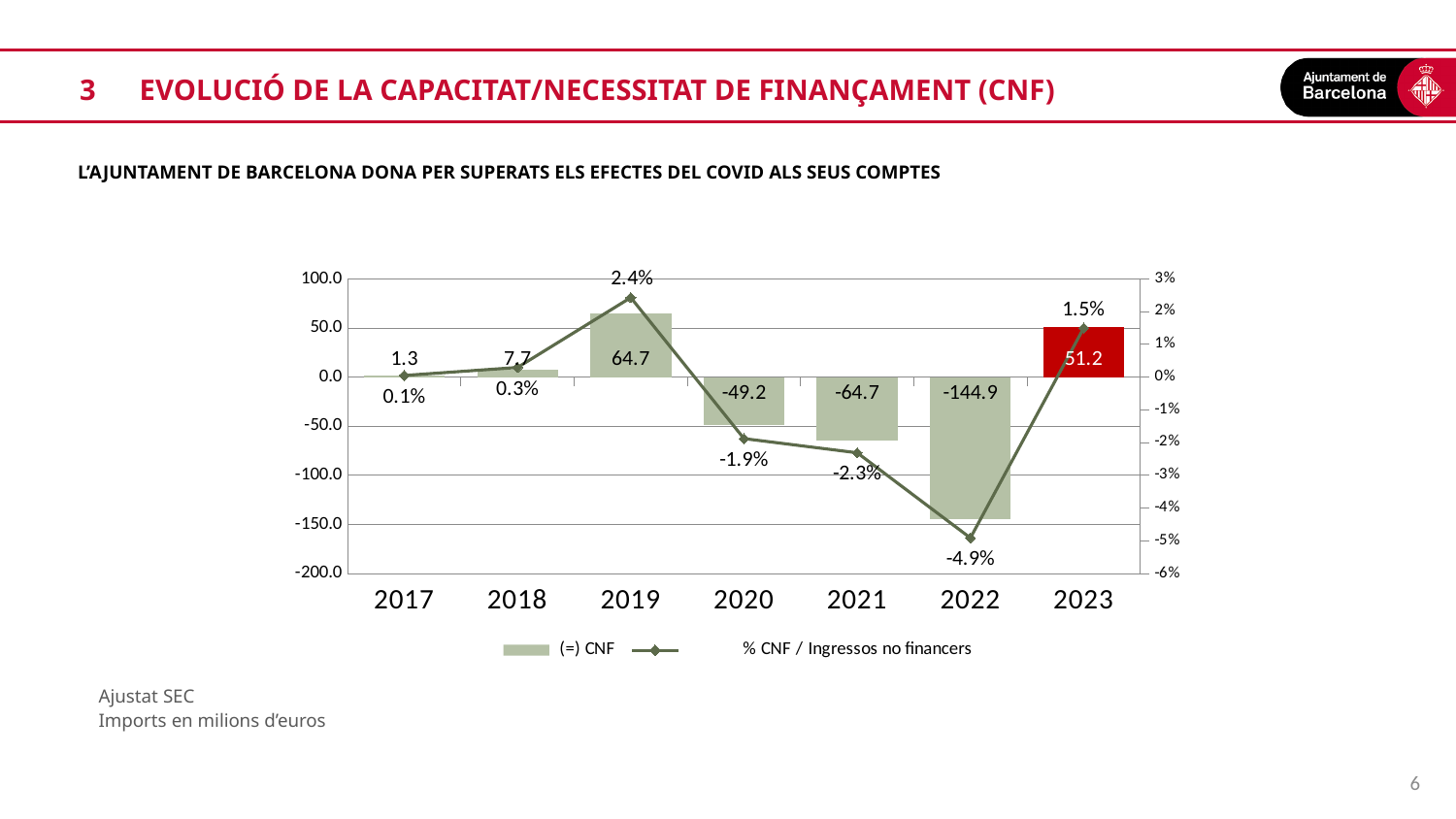
What is the (=) CNF value for 2019? 64.7 How many years are shown on the x axis? 7 How many series does the legend list? 2 What is the % CNF / Ingressos no financers value for 2023? 1.5% Which is larger, the (=) CNF value for 2020 or for 2021? 2020 Which year's bar is coloured red instead of green? 2023 What is the % CNF / Ingressos no financers value for 2021? -2.3% Which year has the highest (=) CNF value? 2019 Does the % CNF / Ingressos no financers line rise or fall from 2019 to 2022? fall Which year has the lowest (=) CNF value? 2022 What is the difference between the (=) CNF values for 2023 and 2018? 43.5 What is the (=) CNF value for 2022? -144.9